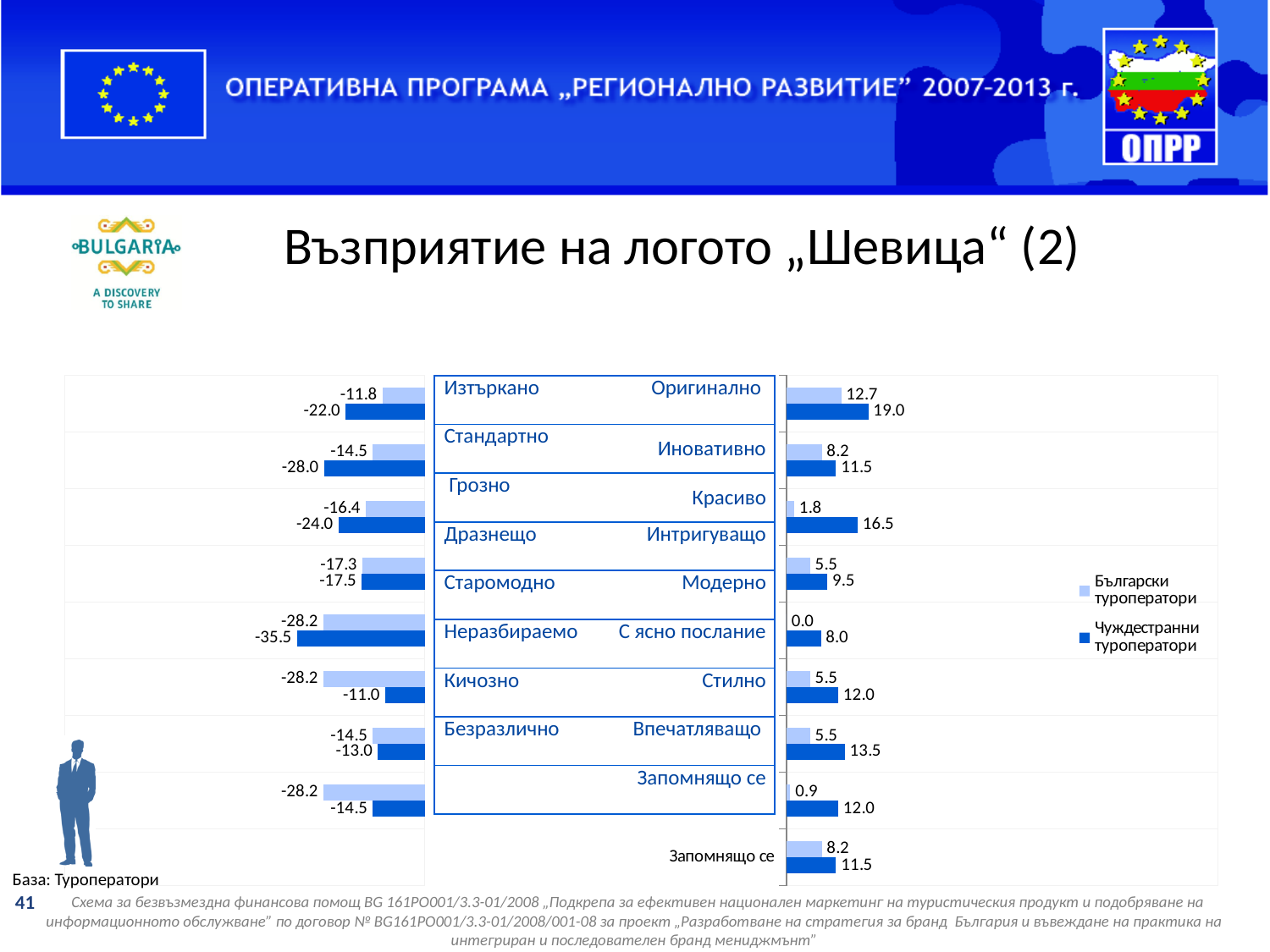
What is the value for Чуждестранни туроператори for Оригинално (top row, right side)? 19.0 What is the difference between the Чуждестранни туроператори and Български туроператори values for Запомнящо се (bottom row)? 3.3 For Запомнящо се (bottom row), which series has the larger value, Български туроператори or Чуждестранни туроператори? Чуждестранни туроператори What is the value for Български туроператори for Оригинално (top row, right side)? 12.7 What is the highest positive value shown for Чуждестранни туроператори? 19.0 What is the value for Български туроператори for Запомнящо се (bottom row)? 8.2 What is the value for Чуждестранни туроператори for Запомнящо се (bottom row)? 11.5 What is the lowest (most negative) value shown for Чуждестранни туроператори? -35.5 What type of chart is shown on the slide? bar chart What is the difference between the Чуждестранни туроператори and Български туроператори values for Оригинално? 6.3 How many series does the legend list? 2 What are the two series named in the legend? Български туроператори and Чуждестранни туроператори